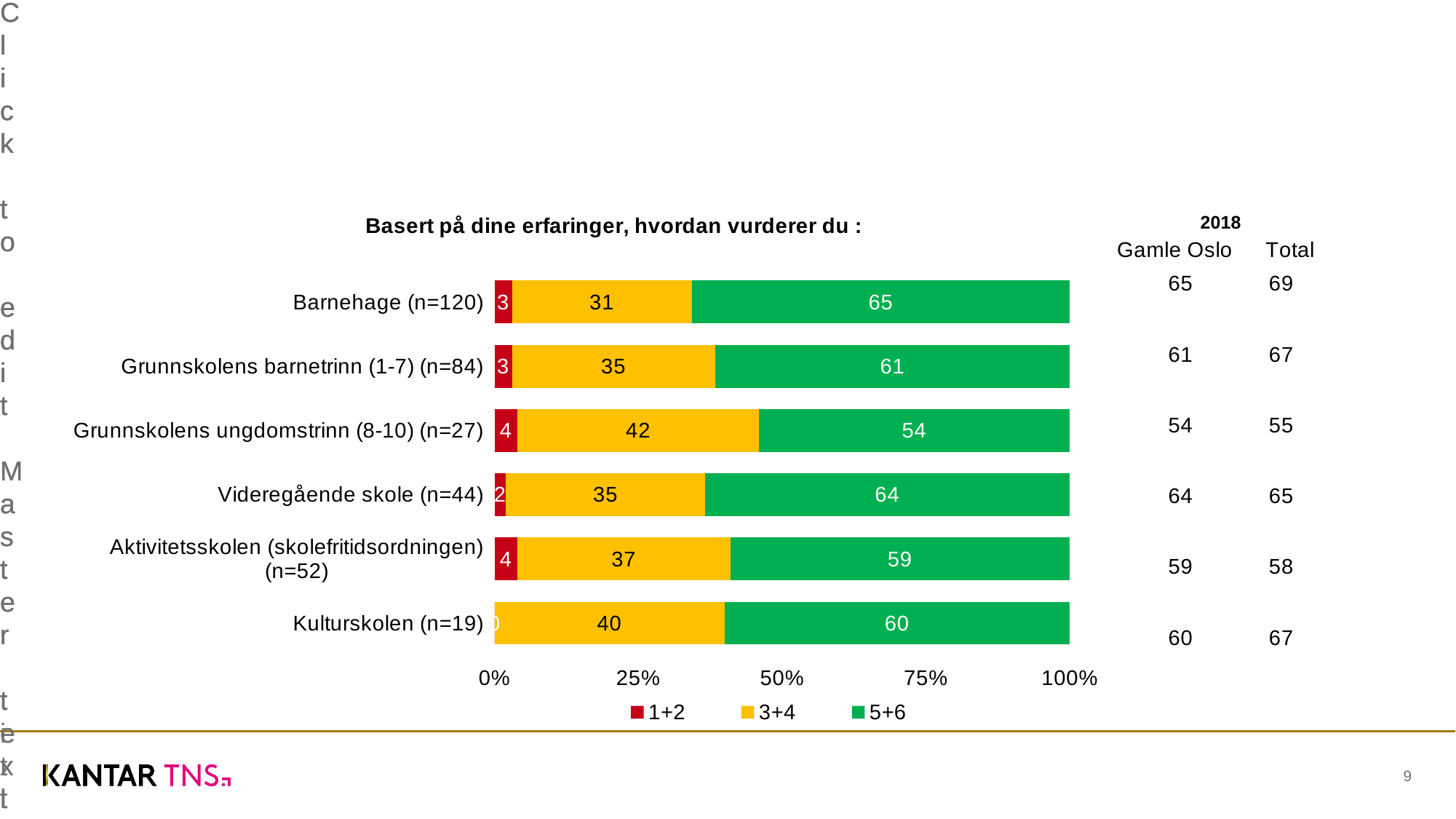
What is the total of the stacked bar for Grunnskolens barnetrinn (1-7) (n=84)? 99 Which has a larger 3+4 value, Kulturskolen (n=19) or Videregående skole (n=44)? Kulturskolen (n=19) Which category has the lowest 5+6 value? Grunnskolens ungdomstrinn (8-10) (n=27) What is the title of the chart? Basert på dine erfaringer, hvordan vurderer du : What is the 5+6 value for Barnehage (n=120)? 65 What is the difference between the 5+6 values for Barnehage (n=120) and Grunnskolens ungdomstrinn (8-10) (n=27)? 11 What is the 3+4 value for Grunnskolens ungdomstrinn (8-10) (n=27)? 42 How many series does the legend list? 3 What kind of chart is shown on the slide? Stacked bar chart What is the 1+2 value for Aktivitetsskolen (skolefritidsordningen) (n=52)? 4 How many categories are shown in the chart? 6 Which category has the highest 5+6 value? Barnehage (n=120)